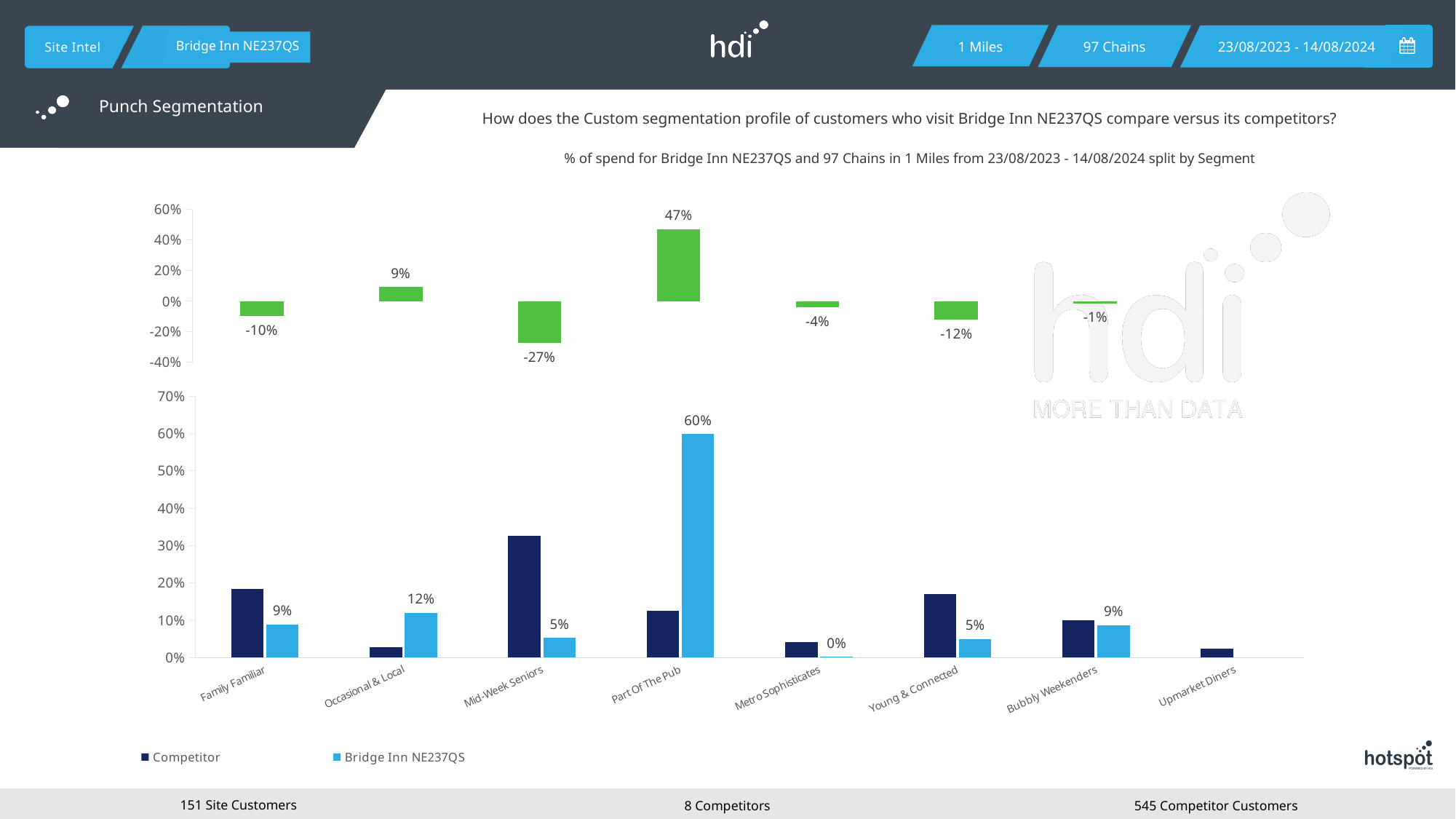
In the top chart, which segment has the lowest value? Mid-Week Seniors In the bottom chart, what is the difference between the Bridge Inn NE237QS values for Part Of The Pub and Occasional & Local? 48% In the bottom chart, which segment has the lowest Bridge Inn NE237QS value? Metro Sophisticates How many segments are shown on the x axis of the bottom chart? 8 In the bottom chart, what is the Bridge Inn NE237QS value for Occasional & Local? 12% In the bottom chart, is the Competitor value for Mid-Week Seniors greater or less than 30%? greater In the bottom chart, which is larger for Mid-Week Seniors: the Competitor value or the Bridge Inn NE237QS value? Competitor What kind of chart is the bottom chart? Bar chart How many series does the legend of the bottom chart list? 2 In the bottom chart, what is the Bridge Inn NE237QS value for Part Of The Pub? 60% In the top chart, what is the value for Part Of The Pub? 47% In the bottom chart, which segment has the highest Bridge Inn NE237QS value? Part Of The Pub